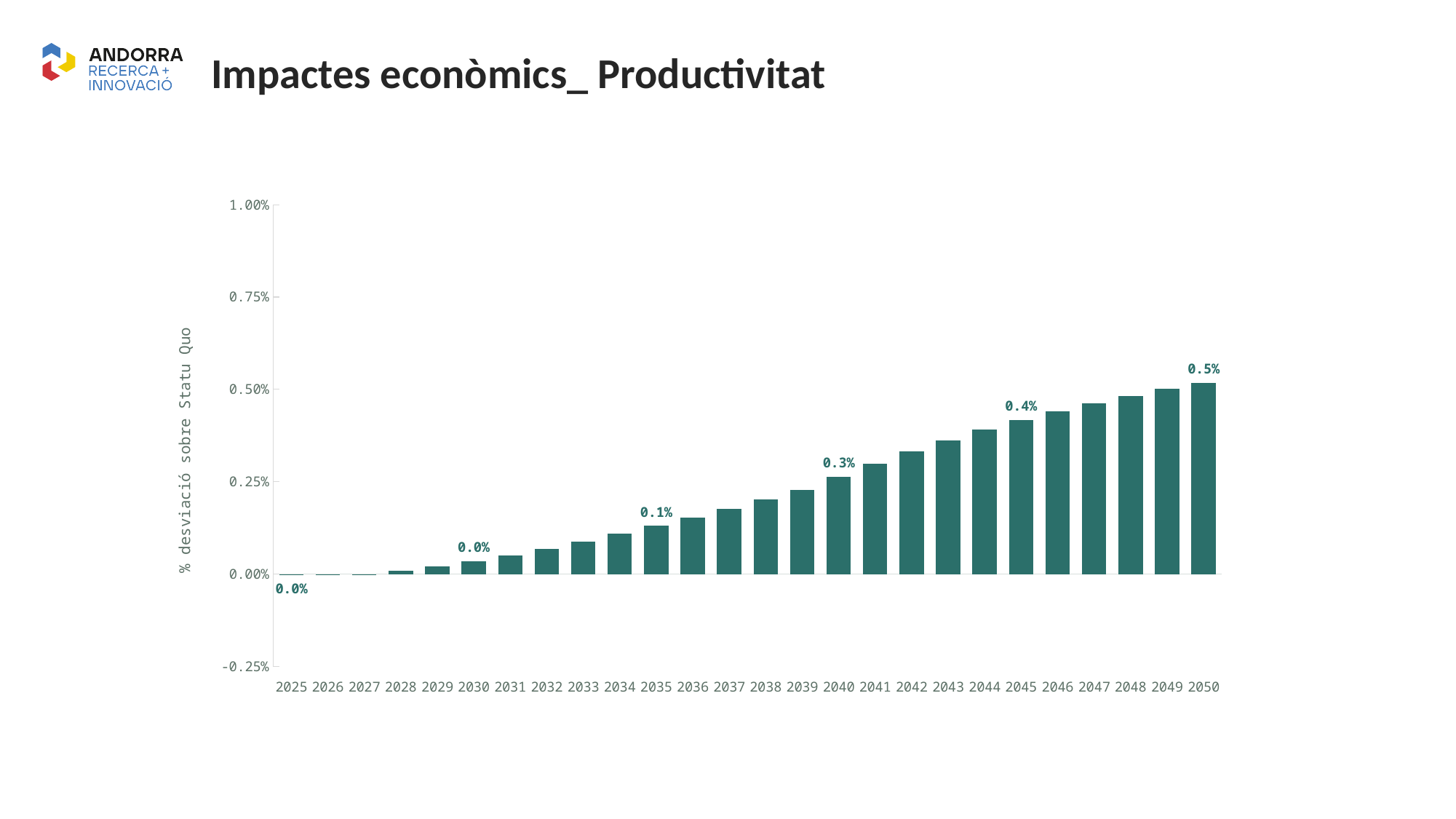
How many years are shown on the x axis? 26 What is the difference between the values for 2050 and 2040? 0.2% Which year has the highest value? 2050 What kind of chart is shown on the slide? bar chart What is the value for 2040? 0.3% Is the value for 2046 greater or less than 0.50%? less Is the value for 2038 greater or less than 0.25%? less What is the value for 2035? 0.1% Which is larger, the value for 2050 or the value for 2045? 2050 Do the values rise or fall from 2025 to 2050? rise What is the value for 2050? 0.5% What is the value for 2045? 0.4%